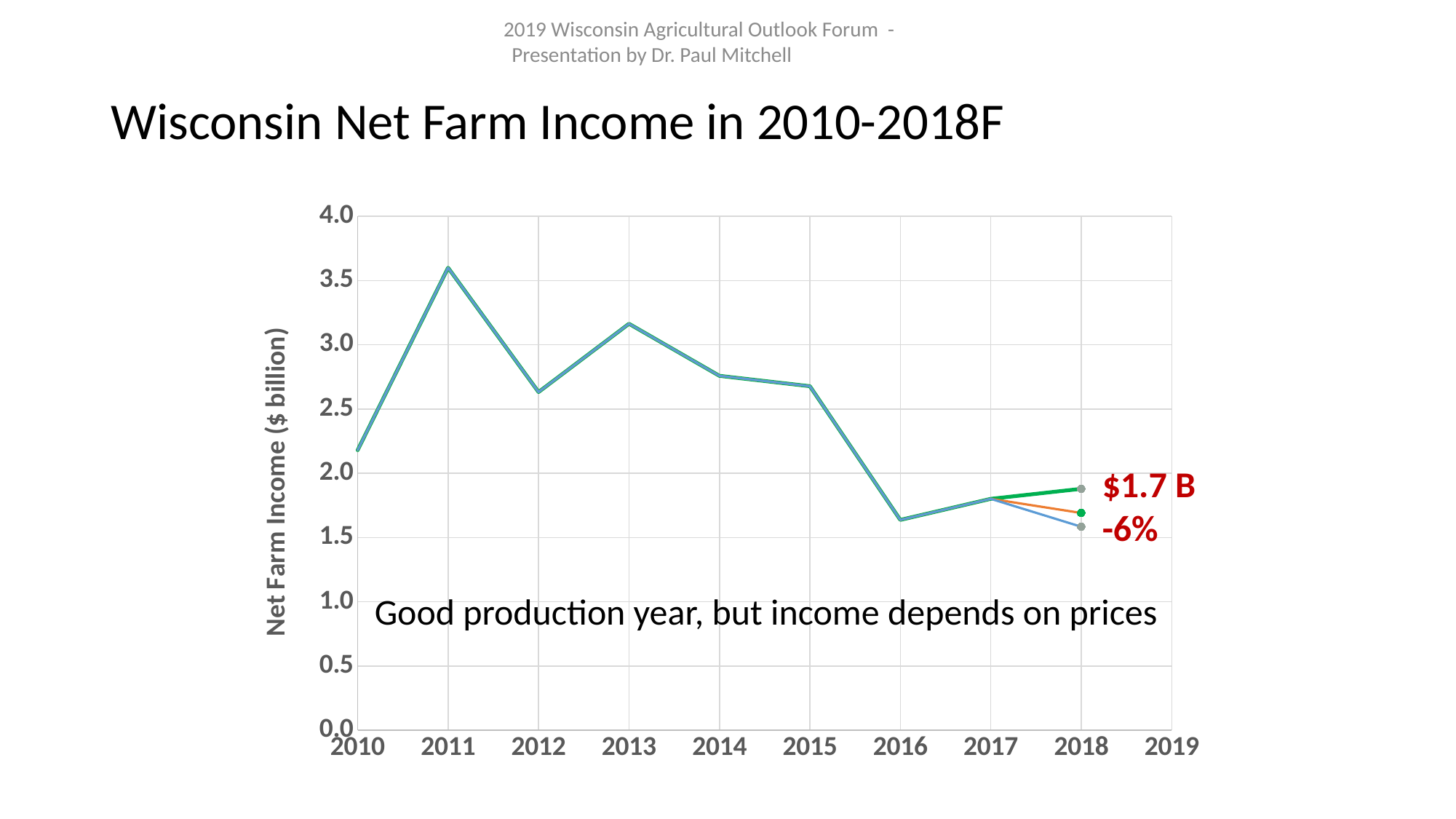
Is the net farm income value for 2011 greater or less than 3.0? greater Is the net farm income value for 2016 greater or less than 2.0? less Did net farm income rise or fall from 2013 to 2016? fall What percentage change is annotated in red next to the 2018 forecast? -6% What is the title of the vertical axis? Net Farm Income ($ billion) In which year was Wisconsin net farm income highest? 2011 What kind of chart is shown on the slide? line chart Is the net farm income value for 2014 greater or less than 3.0? less Which year had higher net farm income, 2011 or 2013? 2011 Which year had higher net farm income, 2010 or 2012? 2012 What value is annotated in red for the 2018 forecast? $1.7 B